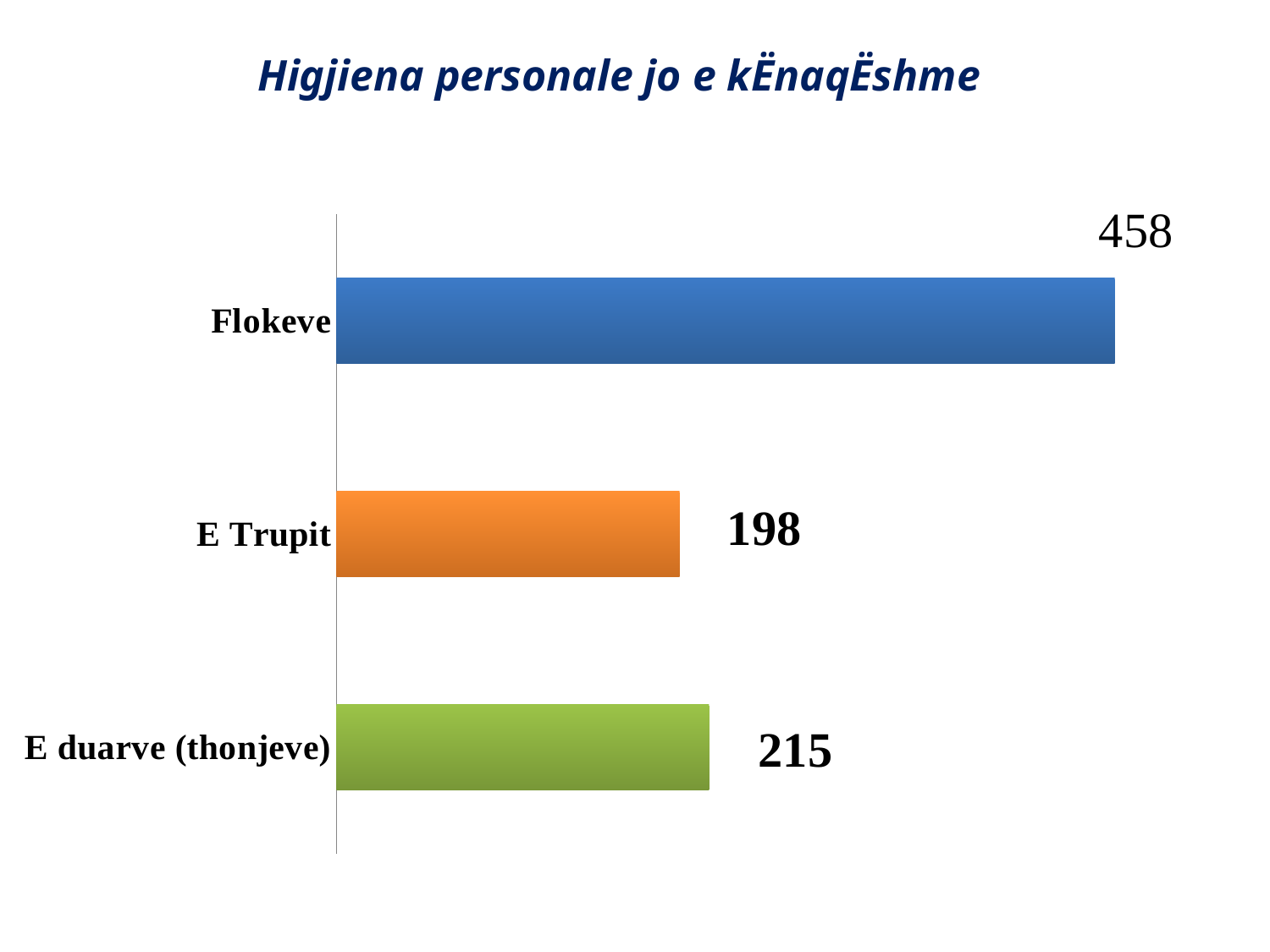
What colour is the bar for E Trupit? orange What is the title of the chart? Higjiena personale jo e kËnaqËshme What is the value for E duarve (thonjeve)? 215 Which category has the lowest value? E Trupit What is the value for E Trupit? 198 How many categories are shown in the chart? 3 What is the difference between the values for E duarve (thonjeve) and E Trupit? 17 Which category has the highest value? Flokeve What kind of chart is shown on the slide? bar chart What is the difference between the values for Flokeve and E duarve (thonjeve)? 243 What is the value for Flokeve? 458 Which is larger, the value for Flokeve or the value for E Trupit? Flokeve